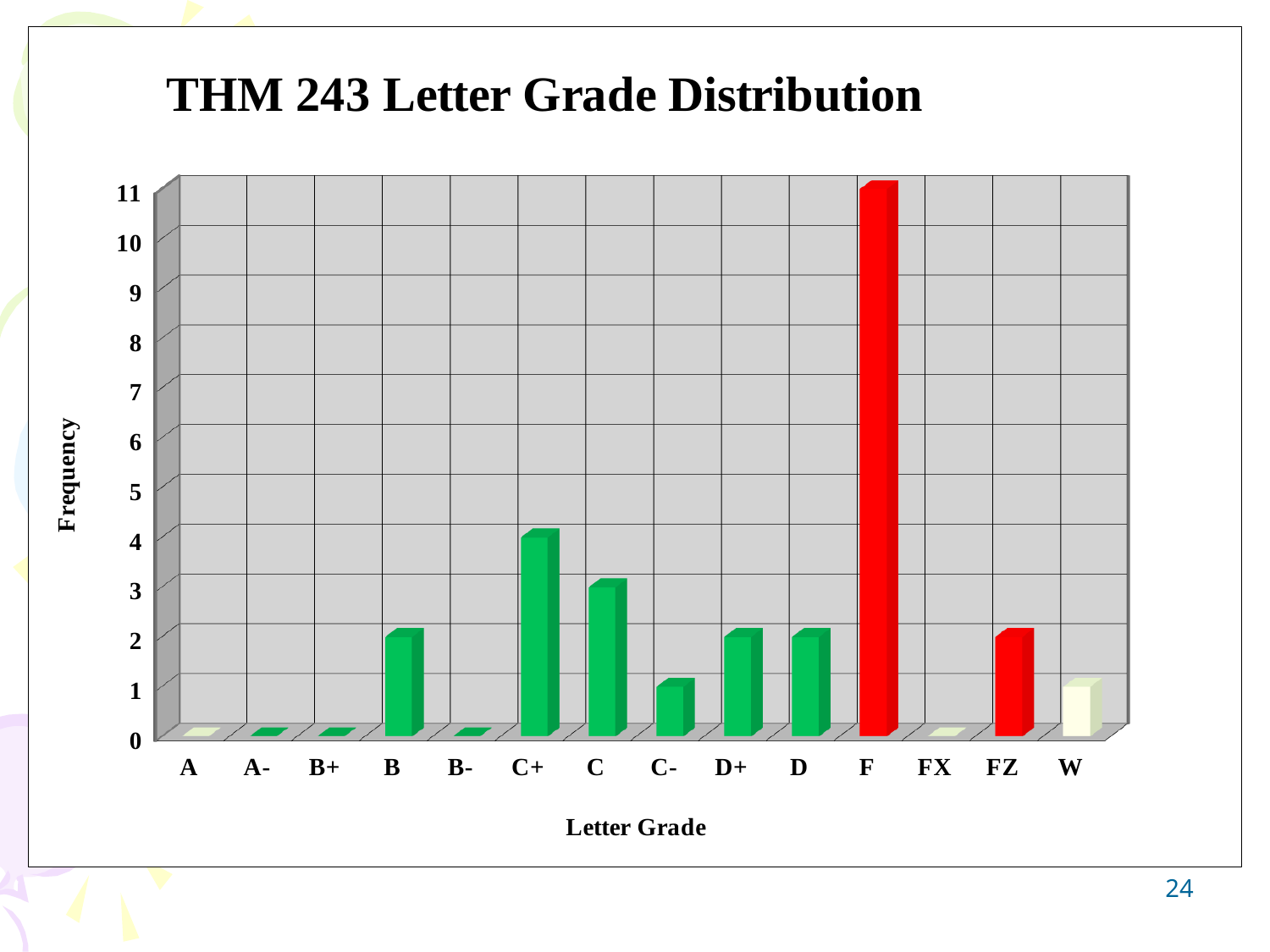
Which letter grade has the highest frequency? F Which is larger, the frequency for C+ or the frequency for C? C+ What is the title of the chart? THM 243 Letter Grade Distribution How many letter grade categories are shown on the x axis? 14 What is the frequency for the letter grade B? 2 What is the difference between the frequency for F and the frequency for C+? 7 Is the frequency for F greater or less than 10? greater What type of chart is shown on the slide? bar chart What is the frequency for the letter grade C+? 4 What is the frequency for the letter grade F? 11 What is the frequency for the letter grade C? 3 What is the label of the y axis? Frequency